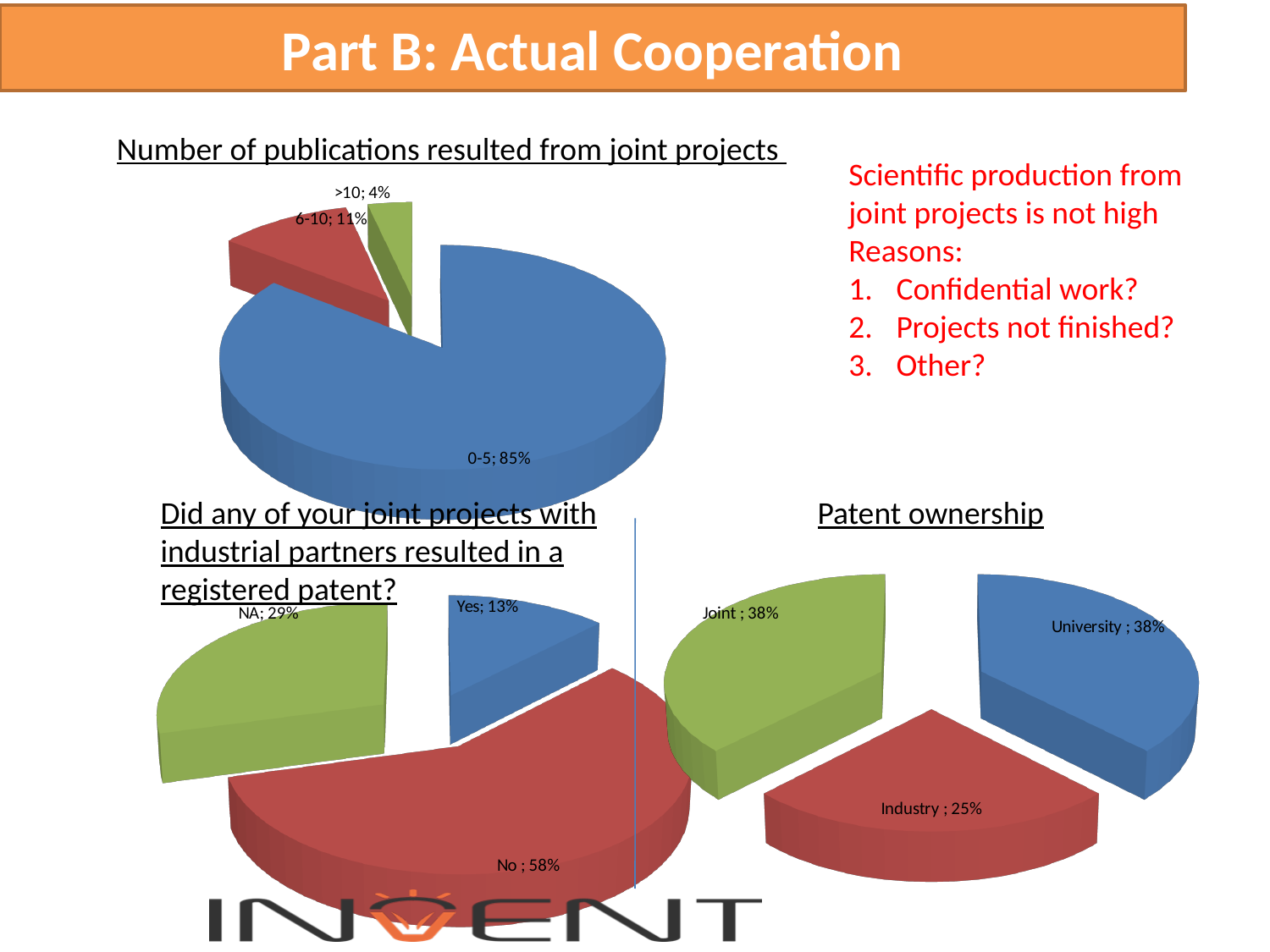
In the 'Did any of your joint projects with industrial partners resulted in a registered patent?' chart, which is larger, NA or Yes? NA In the 'Number of publications resulted from joint projects' chart, how many slices does the pie have? 3 In the 'Patent ownership' chart, what share is labelled for Industry? 25% In the 'Did any of your joint projects with industrial partners resulted in a registered patent?' chart, what share is labelled for No? 58% In the 'Number of publications resulted from joint projects' chart, what share is labelled for the 0-5 category? 85% In the 'Number of publications resulted from joint projects' chart, what share is labelled for the >10 category? 4% In the 'Number of publications resulted from joint projects' chart, what is the difference between the 6-10 share and the >10 share? 7% In the 'Number of publications resulted from joint projects' chart, which category has the largest slice? 0-5 In the 'Did any of your joint projects with industrial partners resulted in a registered patent?' chart, which category has the smallest slice? Yes What type of chart is the 'Patent ownership' chart? Pie chart In the 'Patent ownership' chart, what is the difference between the University share and the Industry share? 13% In the 'Patent ownership' chart, which category has the smallest slice? Industry